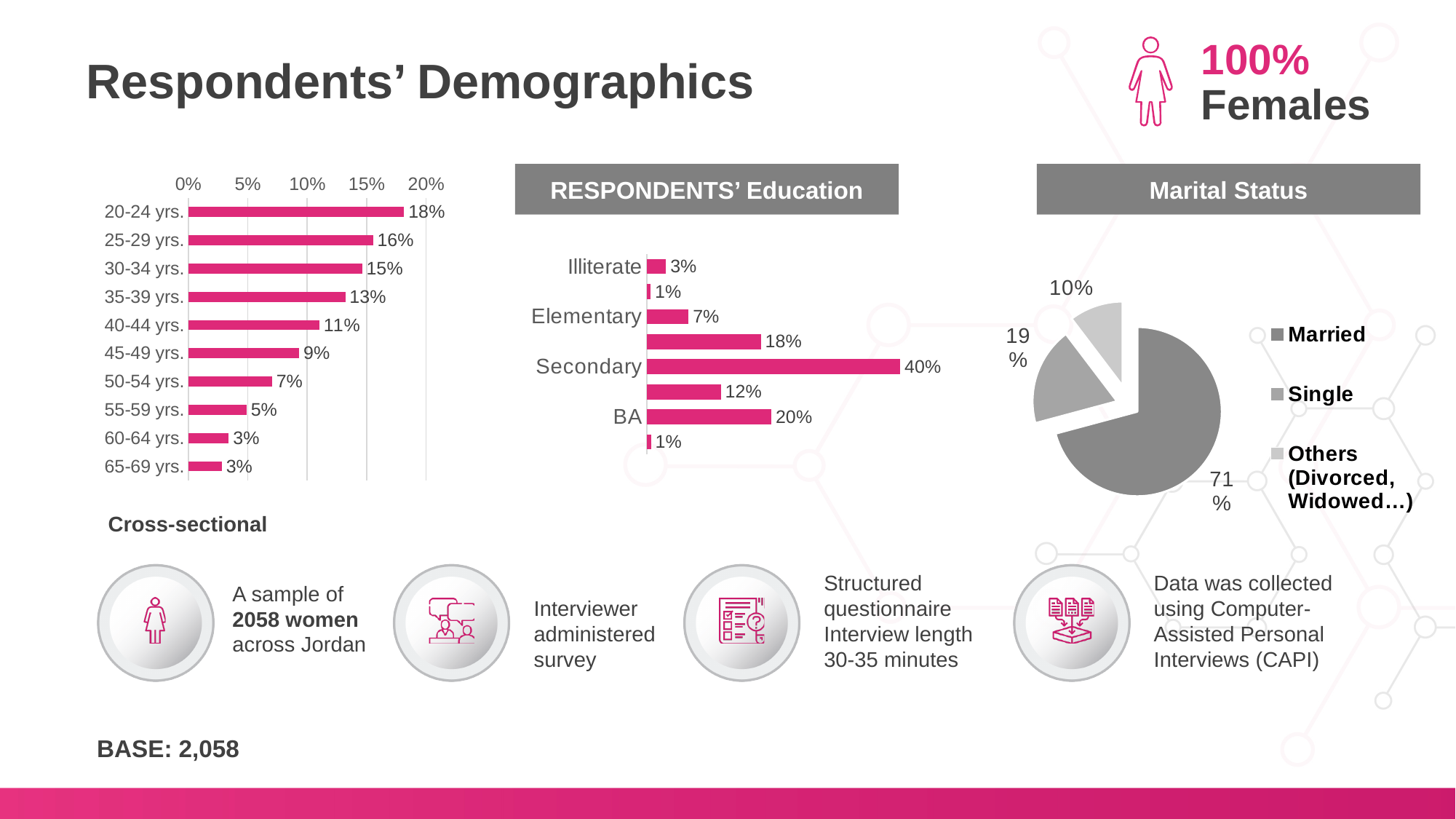
In the Marital Status pie chart, how many categories does the legend list? 3 In the age-group bar chart on the left, what percentage of respondents are aged 45-49 yrs.? 9% In the RESPONDENTS' Education chart, what percentage of respondents are Illiterate? 3% In the age-group bar chart on the left, how many age groups are shown? 10 In the RESPONDENTS' Education chart, which is larger, the value for BA or the value for Elementary? BA In the Marital Status pie chart, what share of respondents are Married? 71% In the age-group bar chart on the left, what is the difference between the shares for 25-29 yrs. and 50-54 yrs.? 9% In the age-group bar chart on the left, what percentage of respondents are aged 20-24 yrs.? 18% In the RESPONDENTS' Education chart, what percentage of respondents have Secondary education? 40% In the age-group bar chart on the left, which age group has the highest share of respondents? 20-24 yrs. In the age-group bar chart on the left, do the values rise or fall as the age groups get older? fall What kind of chart is used for Marital Status? pie chart